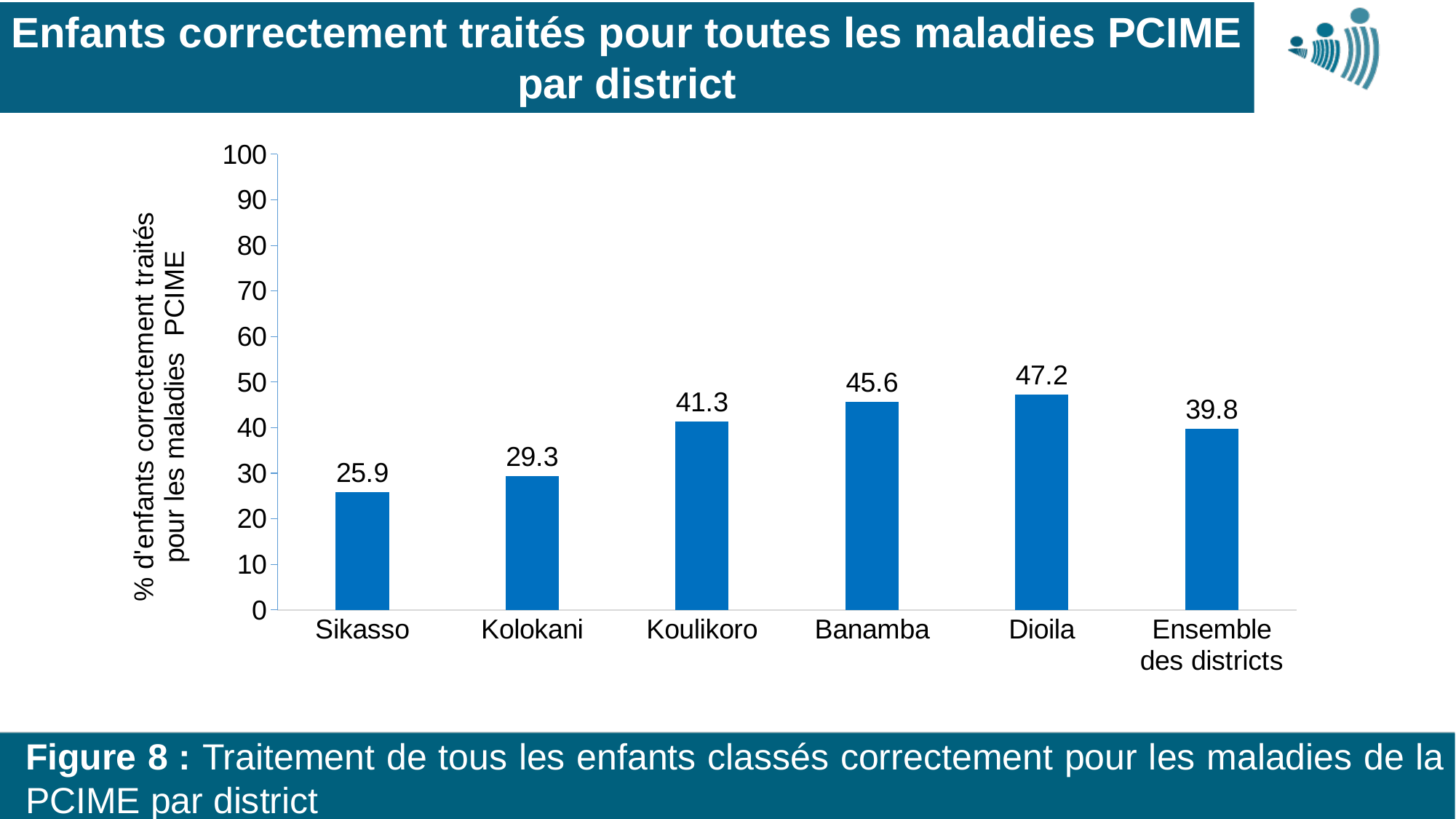
What is the difference between the values for Banamba and Kolokani? 16.3 Is the value for Kolokani greater or less than 30? less What is the difference between the values for Dioila and Sikasso? 21.3 What is the value for Koulikoro? 41.3 How many categories are shown on the x axis? 6 What kind of chart is shown on the slide? bar chart Which district has the highest value? Dioila What is the value for Sikasso? 25.9 What is the label of the y axis? % d'enfants correctement traités pour les maladies PCIME Which district has the lowest value? Sikasso What is the value for Ensemble des districts? 39.8 Which is larger, the value for Koulikoro or the value for Ensemble des districts? Koulikoro